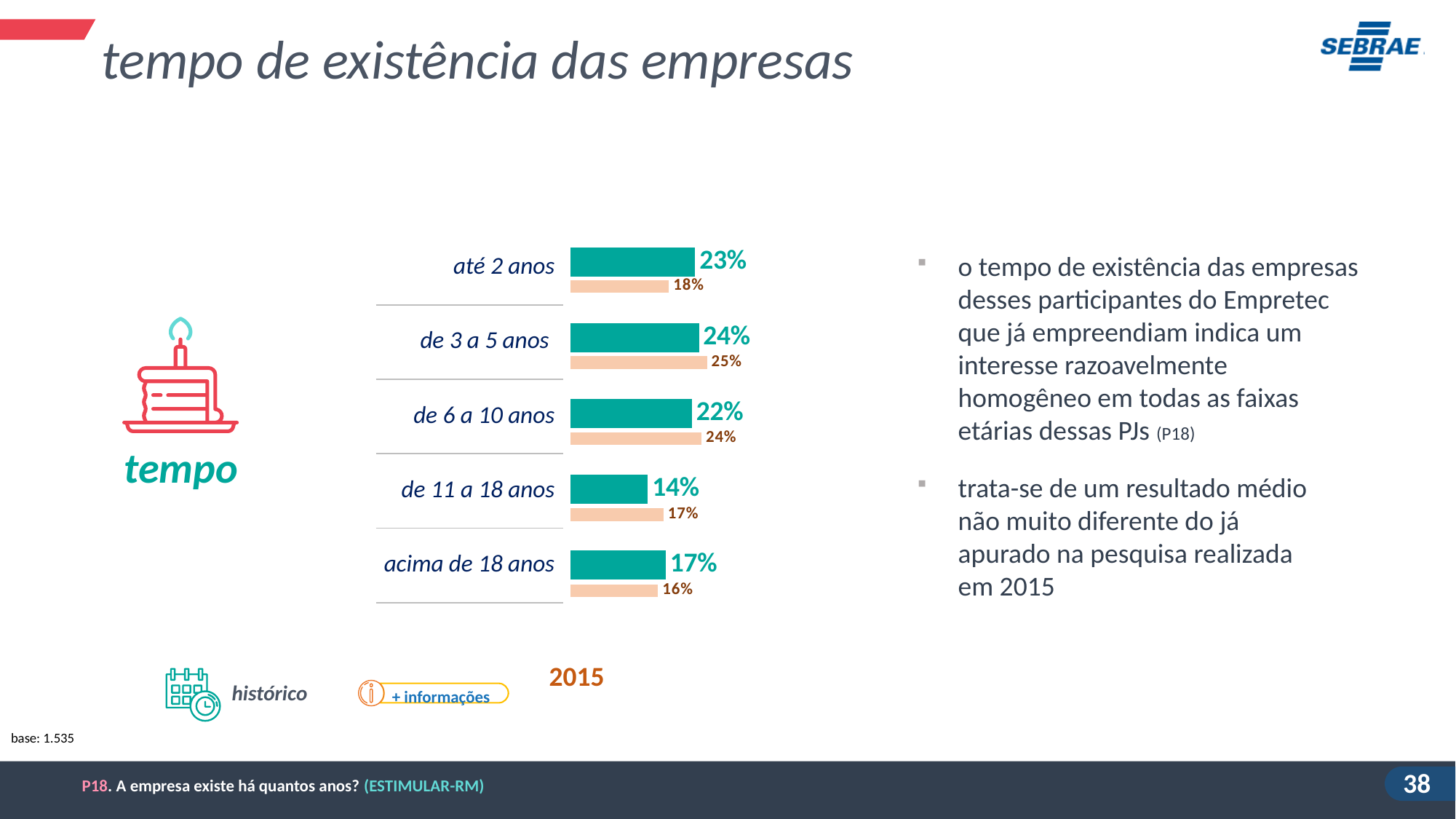
What kind of chart is shown on the slide? bar chart How many categories (time ranges) does the chart show? 5 What is the value of the teal bar for 'de 11 a 18 anos'? 14% What year is shown as the label for the orange comparison bars? 2015 What is the value of the teal bar for 'até 2 anos'? 23% For 'de 6 a 10 anos', which is larger: the teal value or the 2015 value? the 2015 value (24%) Which category has the lowest 2015 (orange) value? acima de 18 anos Which category has the highest teal bar value? de 3 a 5 anos What is the 2015 (orange) value for 'acima de 18 anos'? 16% Which category has the lowest teal bar value? de 11 a 18 anos What is the 2015 (orange) value for 'de 3 a 5 anos'? 25% What is the difference between the teal value and the 2015 value for 'até 2 anos'? 5 percentage points